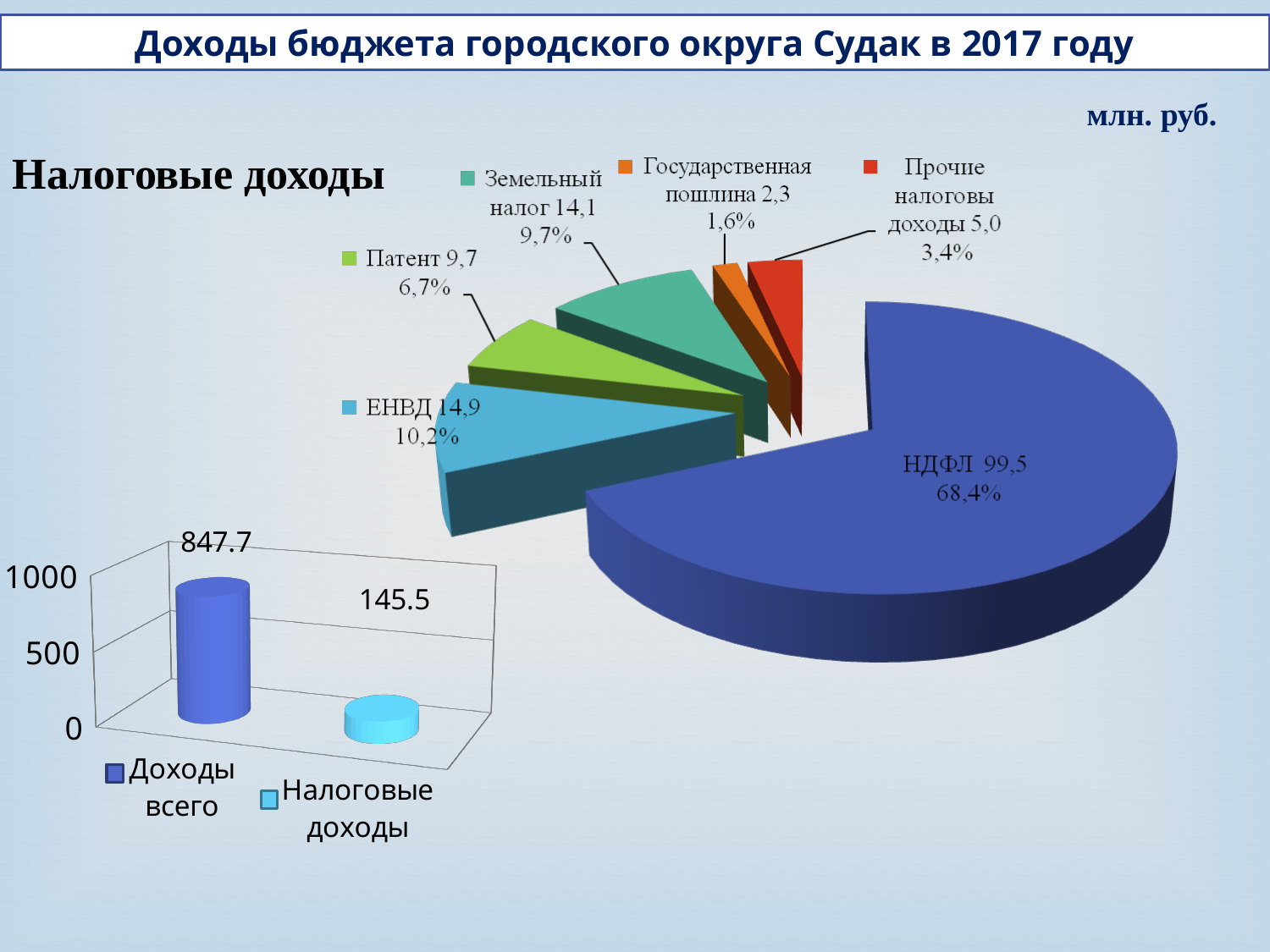
In the pie chart 'Налоговые доходы', what share of the pie does НДФЛ take? 68,4% What type of chart is shown at the bottom left of the slide? Bar chart In the bar chart at the bottom left, what is the difference between Доходы всего and Налоговые доходы? 702.2 In the bar chart at the bottom left, what is the value for Доходы всего? 847.7 In the pie chart 'Налоговые доходы', which category has the largest slice? НДФЛ In the pie chart 'Налоговые доходы', which category has the smallest slice? Государственная пошлина In the pie chart 'Налоговые доходы', what value is shown for ЕНВД? 14,9 In the pie chart 'Налоговые доходы', what percentage is shown for Земельный налог? 9,7% In the bar chart at the bottom left, what is the value for Налоговые доходы? 145.5 In the pie chart 'Налоговые доходы', which is larger: Патент or Прочие налоговые доходы? Патент In the pie chart 'Налоговые доходы', what value is shown for НДФЛ? 99,5 In the pie chart 'Налоговые доходы', how many slices are there? 6